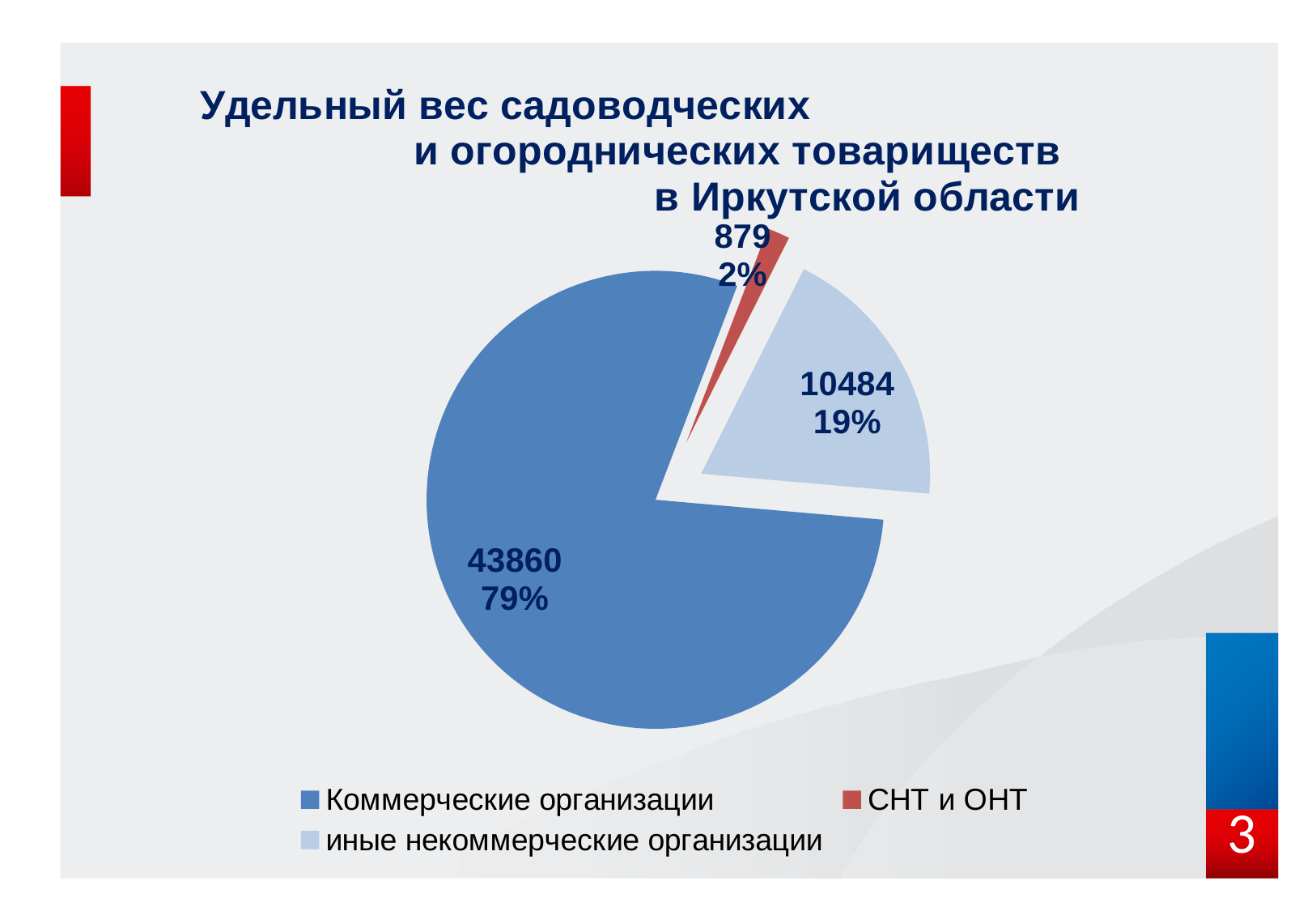
What kind of chart is shown on the slide? pie chart Which category has the smallest slice? СНТ и ОНТ What is the value for Коммерческие организации? 43860 What share of the pie does Коммерческие организации take? 79% What colour is the slice for СНТ и ОНТ? red What is the value for СНТ и ОНТ? 879 What share of the pie does СНТ и ОНТ take? 2% Which category has the largest slice? Коммерческие организации What is the value for иные некоммерческие организации? 10484 What share of the pie does иные некоммерческие организации take? 19% What is the difference between the values for Коммерческие организации and иные некоммерческие организации? 33376 How many slices does the pie chart have? 3